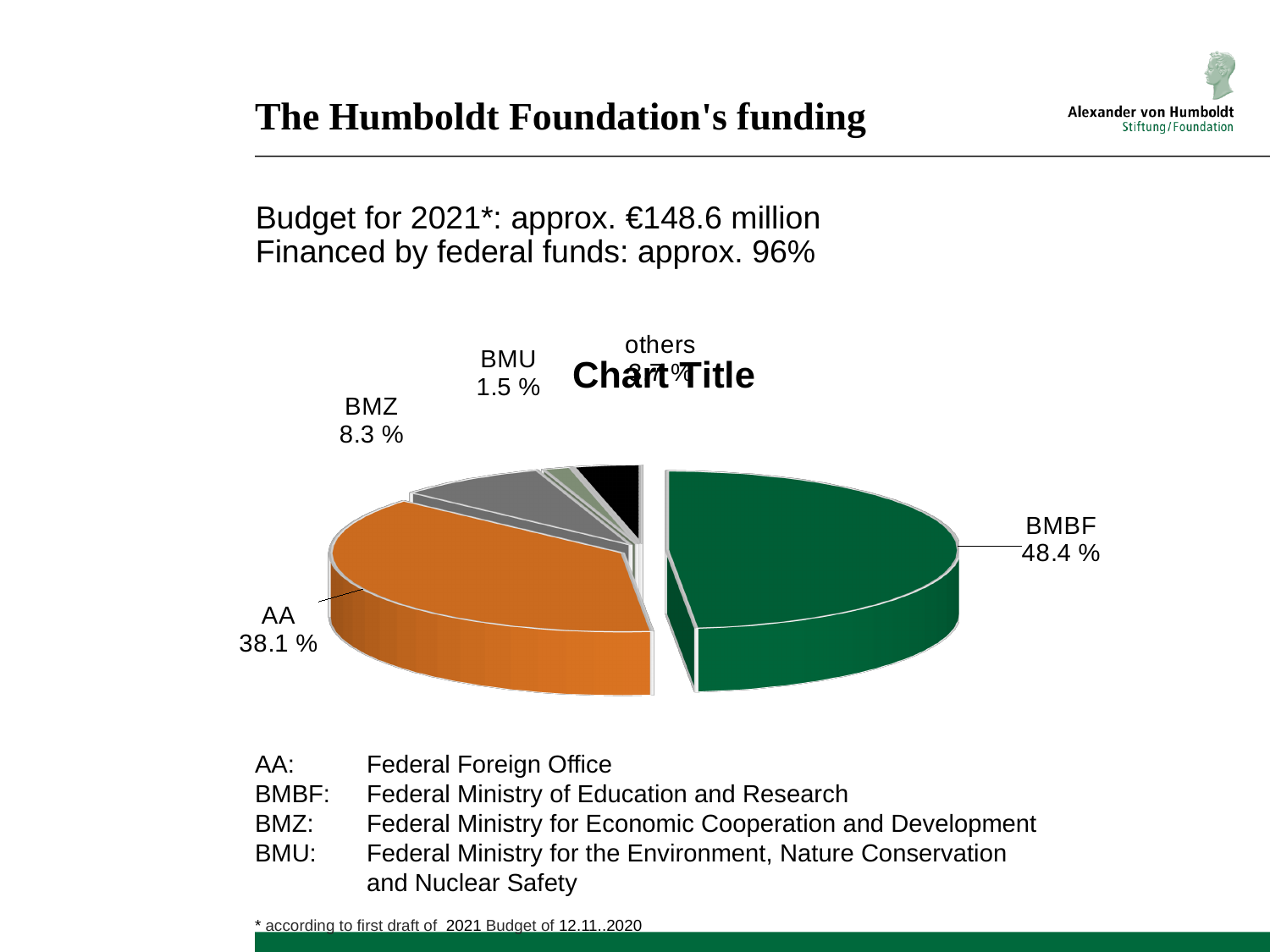
Which funding source has the largest slice of the pie chart? BMBF What type of chart is shown on the slide? Pie chart How many slices does the pie chart have? 5 What colour is the BMBF slice of the pie chart? Green What percentage is labelled for BMU in the pie chart? 1.5 % What is the difference in percentage points between the BMZ and BMU slices? 6.8 Which slice is larger, BMZ or BMU? BMZ What is the difference in percentage points between the BMBF and AA slices? 10.3 Which labelled funding source has the smallest slice of the pie chart? BMU What percentage is labelled for BMZ in the pie chart? 8.3 % What share of the Humboldt Foundation's funding comes from BMBF according to the pie chart? 48.4 % What share of funding does the pie chart show for AA? 38.1 %